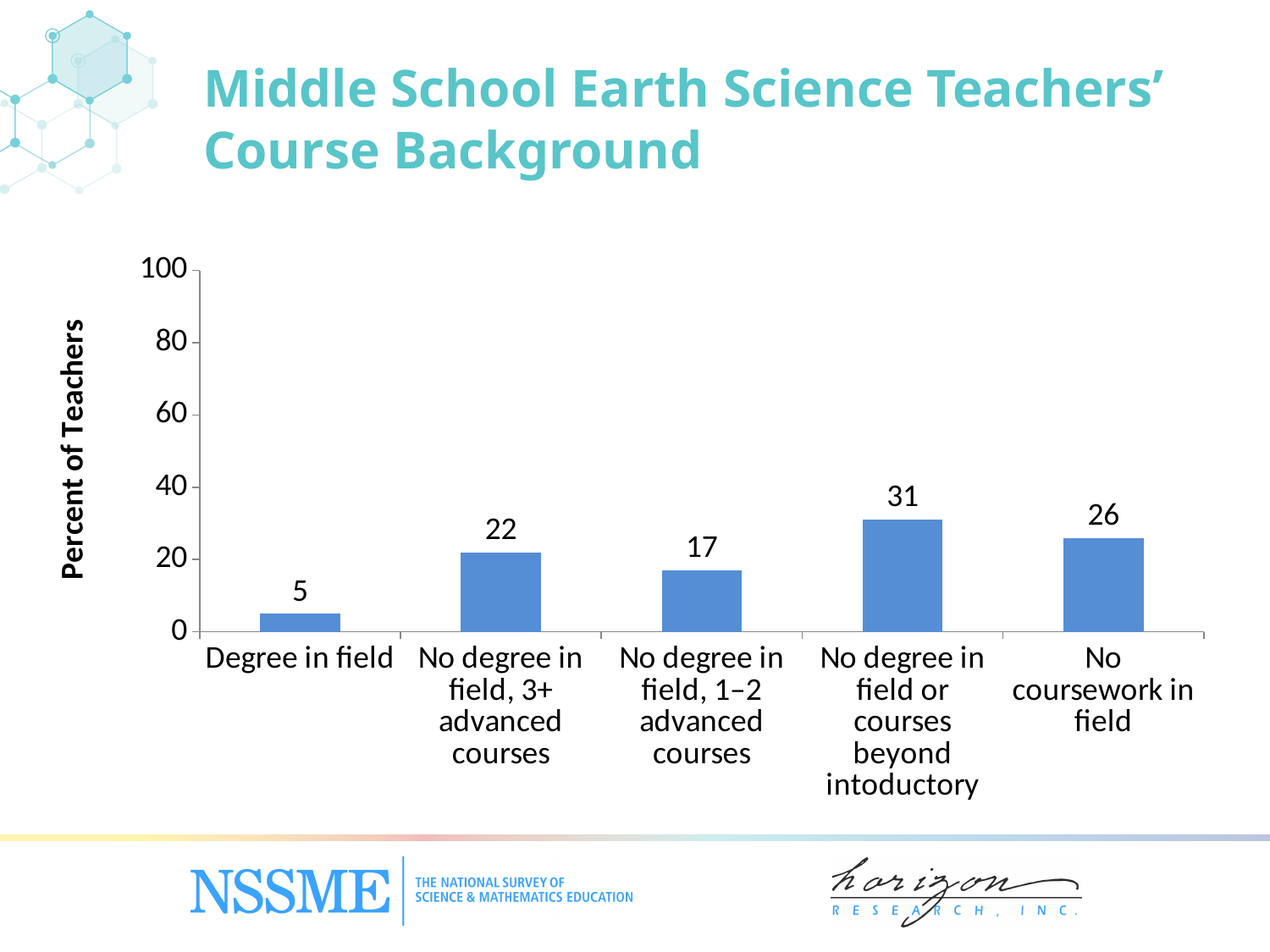
Which category has the highest percent of teachers? No degree in field or courses beyond intoductory How many categories are shown on the x axis? 5 What is the value for 'No degree in field, 3+ advanced courses'? 22 Which is larger: 'No degree in field, 3+ advanced courses' or 'No degree in field, 1–2 advanced courses'? No degree in field, 3+ advanced courses Which category has the lowest percent of teachers? Degree in field What is the label of the y axis? Percent of Teachers What is the difference between 'No degree in field or courses beyond intoductory' and 'No coursework in field'? 5 What percent of teachers have a degree in field? 5 Is the value for 'No degree in field or courses beyond intoductory' greater or less than 20? greater What is the value for 'No degree in field, 1–2 advanced courses'? 17 What percent of teachers have no coursework in field? 26 What kind of chart is shown on the slide? bar chart